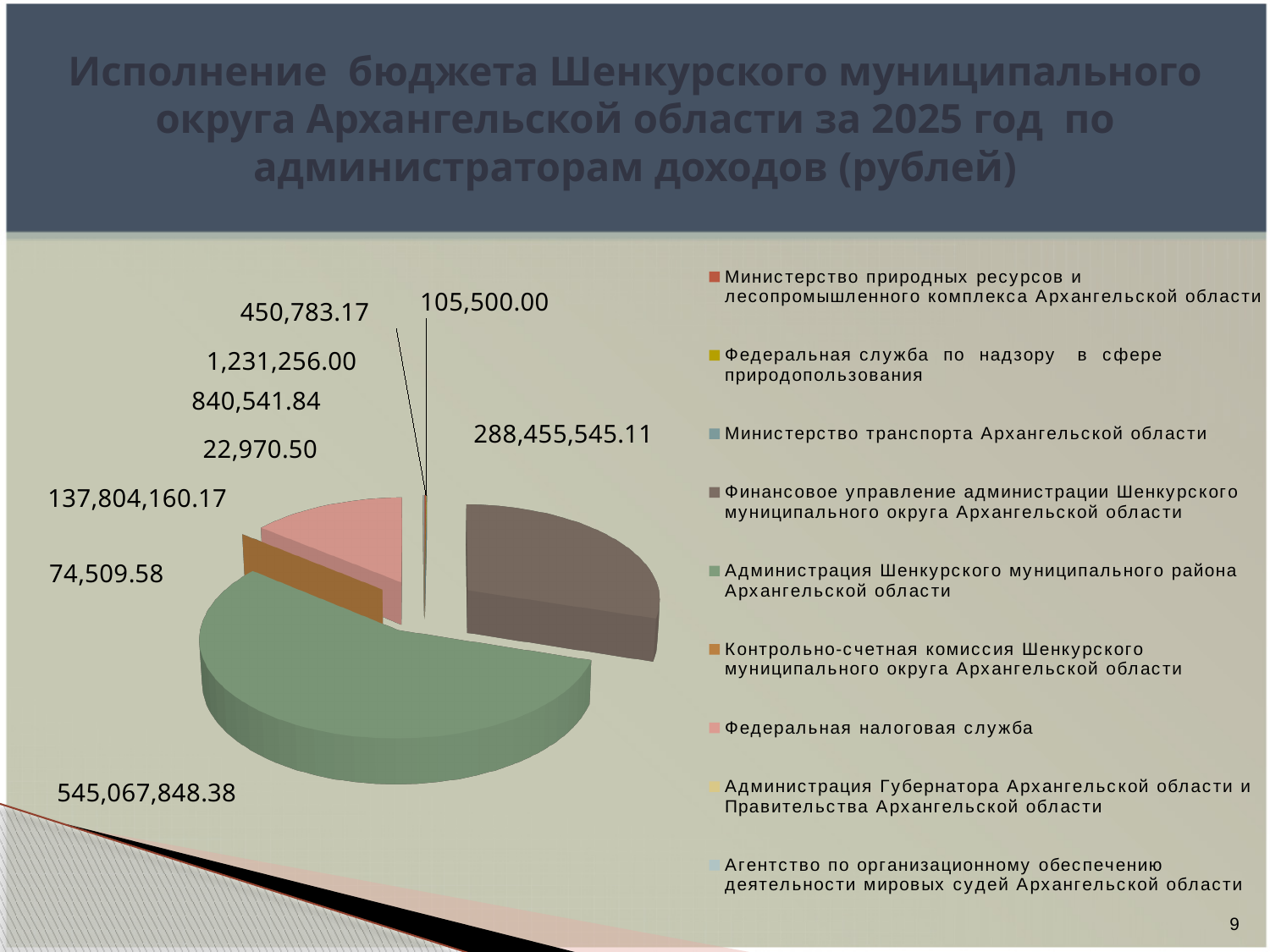
What is the difference between the value for Администрация Шенкурского муниципального района and the value for Финансовое управление администрации Шенкурского муниципального округа? 256,612,303.27 What is the value for Финансовое управление администрации Шенкурского муниципального округа Архангельской области? 288,455,545.11 What colour is the largest slice of the pie? green What is the smallest value printed on the chart? 22,970.50 What is the value for Федеральная налоговая служба? 137,804,160.17 Which category has the largest slice of the pie? Администрация Шенкурского муниципального района Архангельской области What kind of chart is shown on the slide? pie chart What unit does the chart title say the values are in? рублей What is the difference between the value for Финансовое управление администрации Шенкурского муниципального округа and the value for Федеральная налоговая служба? 150,651,384.94 Which is larger: the value for Финансовое управление администрации Шенкурского муниципального округа or the value for Федеральная налоговая служба? Финансовое управление администрации Шенкурского муниципального округа Архангельской области What is the value for Администрация Шенкурского муниципального района Архангельской области? 545,067,848.38 How many categories does the legend list? 9